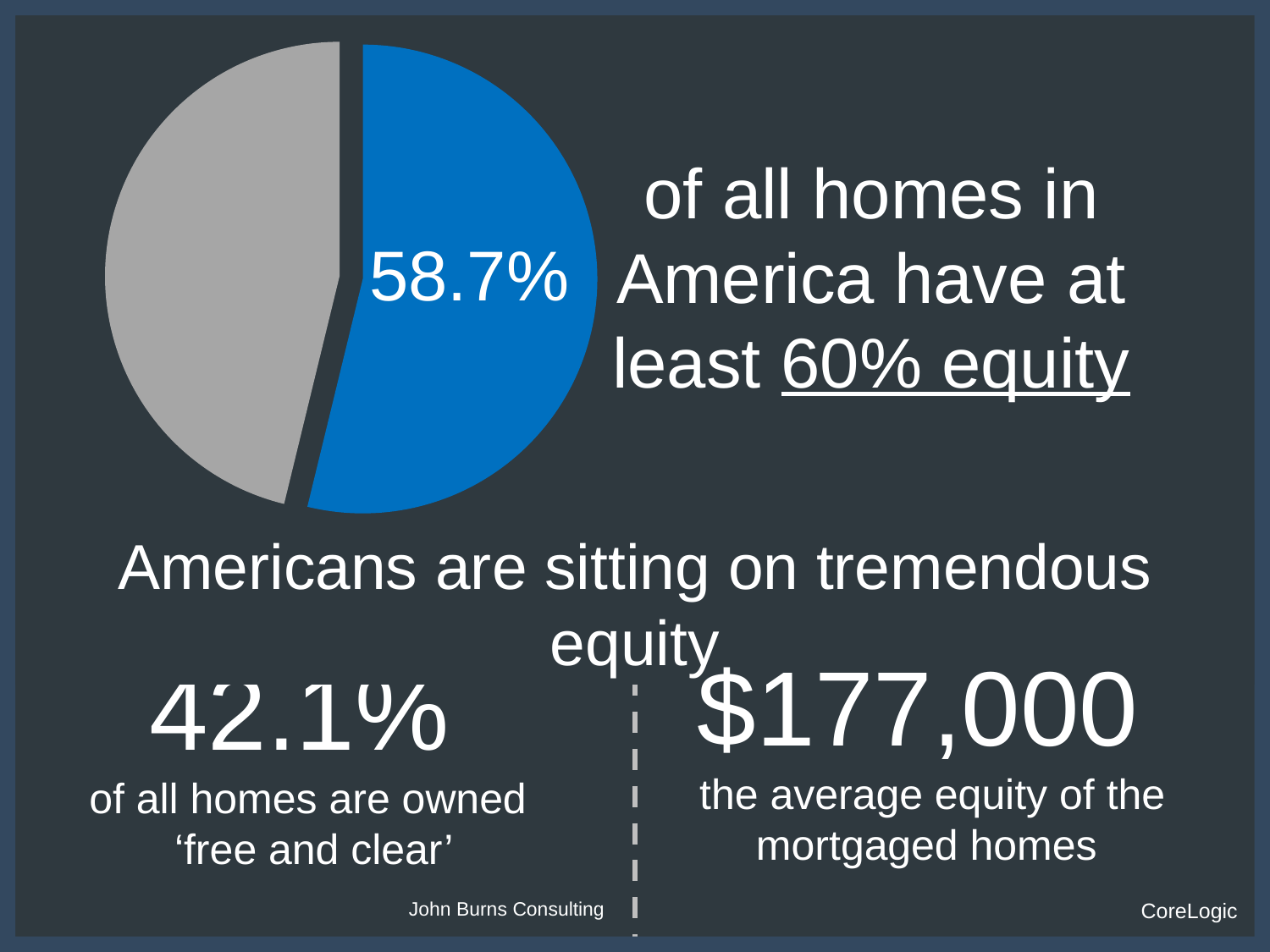
Is the blue slice of the pie chart greater or less than 50% of the pie? greater Which slice of the pie chart is larger, the blue slice or the gray slice? blue Is the gray slice of the pie chart greater or less than 50% of the pie? less What does the 58.7% slice of the pie chart represent, according to the text beside it? homes in America with at least 60% equity What colour is the slice of the pie chart that carries the 58.7% label? blue What percentage is printed on the blue slice of the pie chart? 58.7% What kind of chart is shown on the slide? pie chart According to the pie chart, what share of all homes in America have at least 60% equity? 58.7% How many slices does the pie chart have? 2